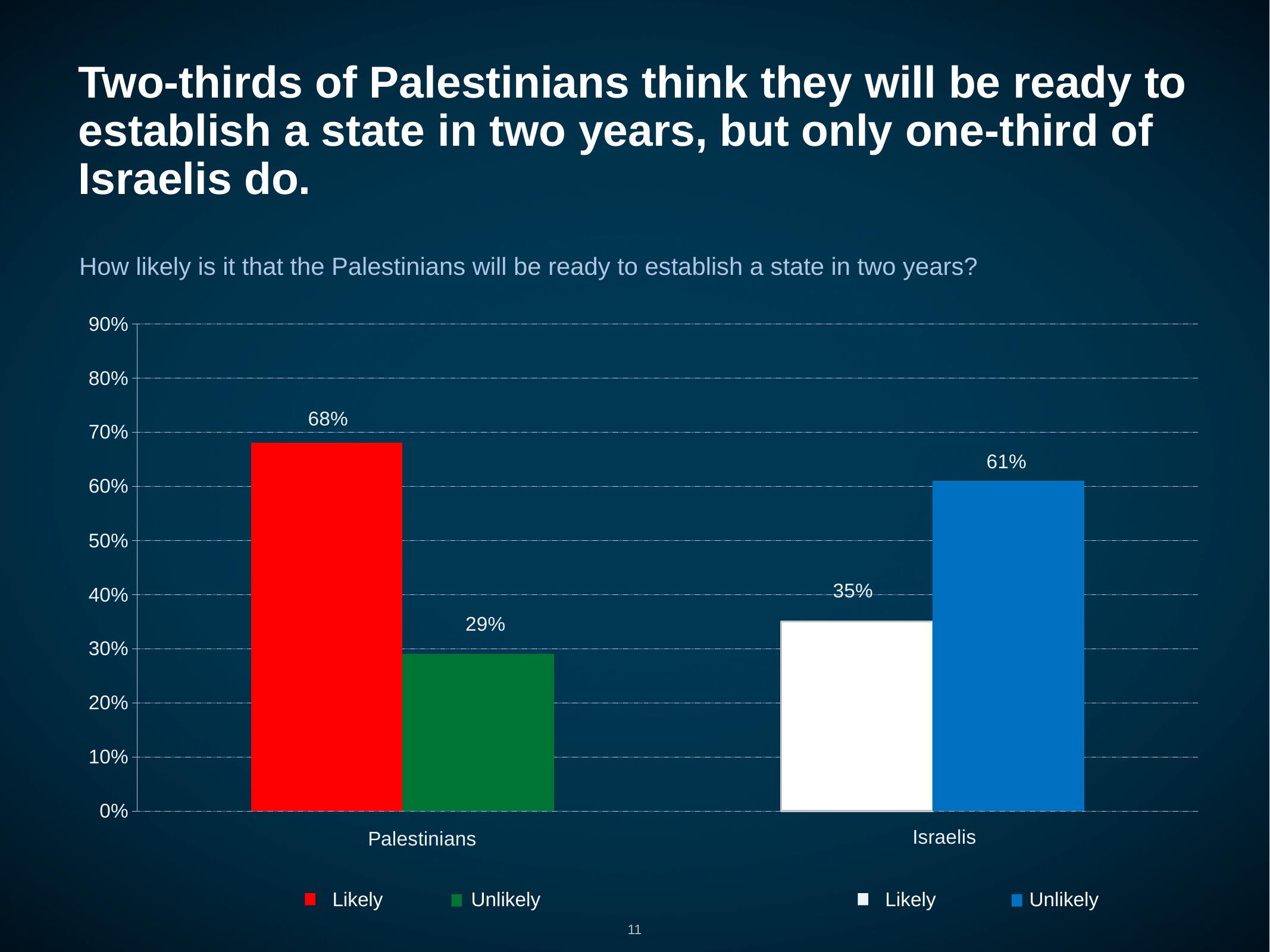
How many groups are shown on the x axis of the chart? 2 What percentage of Palestinians say it is unlikely? 29% What is the difference between the Likely percentage for Palestinians and the Likely percentage for Israelis? 33 percentage points Which bar in the chart has the highest value? Palestinians, Likely (68%) Which bar in the chart has the lowest value? Palestinians, Unlikely (29%) Which is larger: the Unlikely value for Israelis or the Likely value for Israelis? Unlikely for Israelis (61%) What percentage of Israelis say it is likely? 35% What percentage of Israelis say it is unlikely? 61% What percentage of Palestinians say it is likely that the Palestinians will be ready to establish a state in two years? 68% What kind of chart is shown on the slide? Bar chart What colour is the bar for Palestinians who answered Likely? Red What is the difference between the Unlikely percentage for Israelis and the Unlikely percentage for Palestinians? 32 percentage points